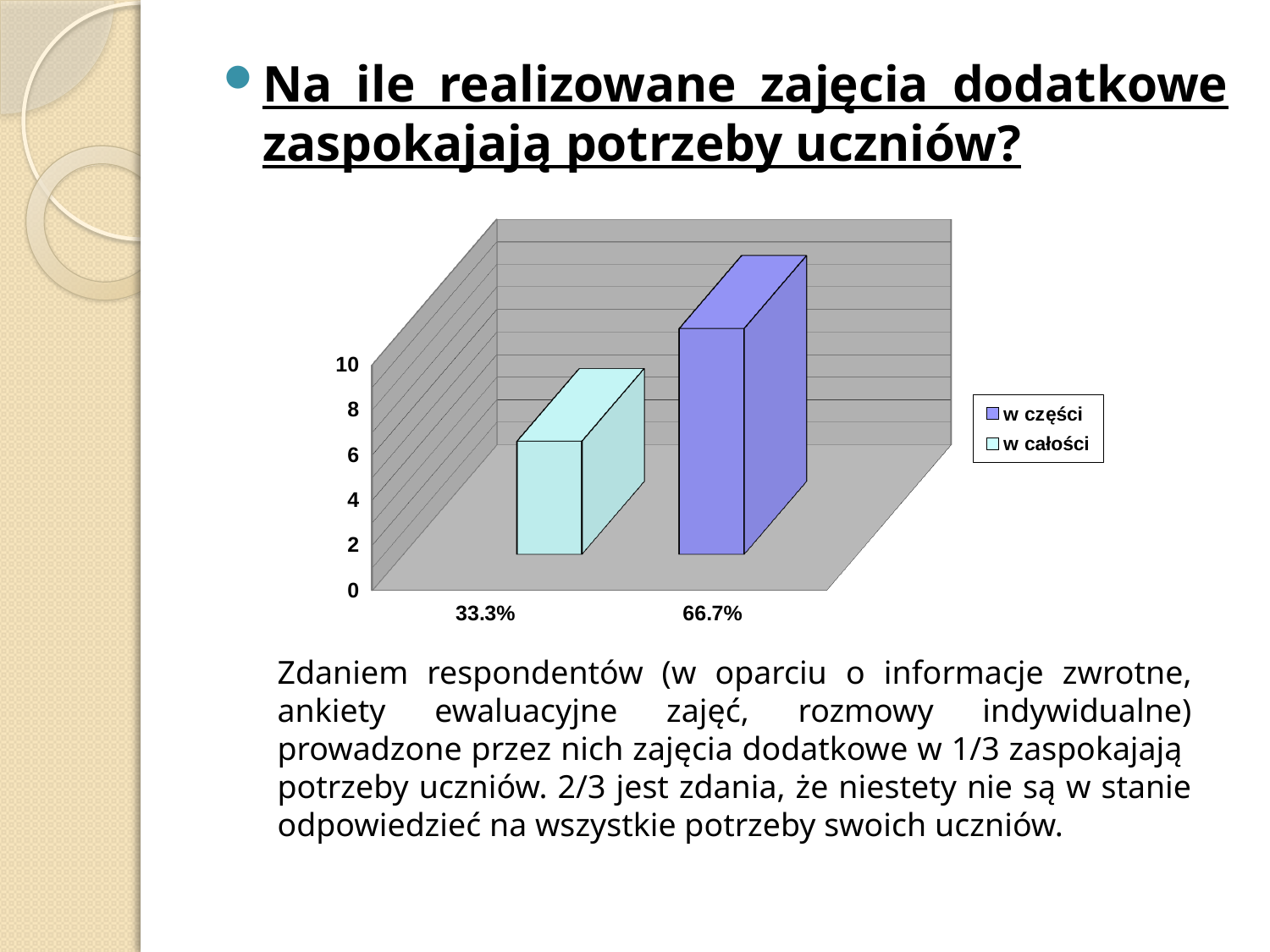
What is the highest value shown on the chart's vertical axis? 10 Is the bar for 'w części' taller or shorter than the bar for 'w całości'? taller What kind of chart is shown on the slide? bar chart How many bars are plotted in the chart? 2 Is the value of the 'w całości' bar greater or less than 2? greater Which legend entry corresponds to the shorter bar, 'w części' or 'w całości'? w całości Which legend entry corresponds to the taller bar, 'w części' or 'w całości'? w części How many entries does the chart legend list? 2 Is the value of the 'w części' bar greater or less than 6? greater What percentage label appears on the x axis beneath the 'w części' bar? 66.7% Is the value of the 'w całości' bar greater or less than 8? less What percentage label appears on the x axis beneath the 'w całości' bar? 33.3%